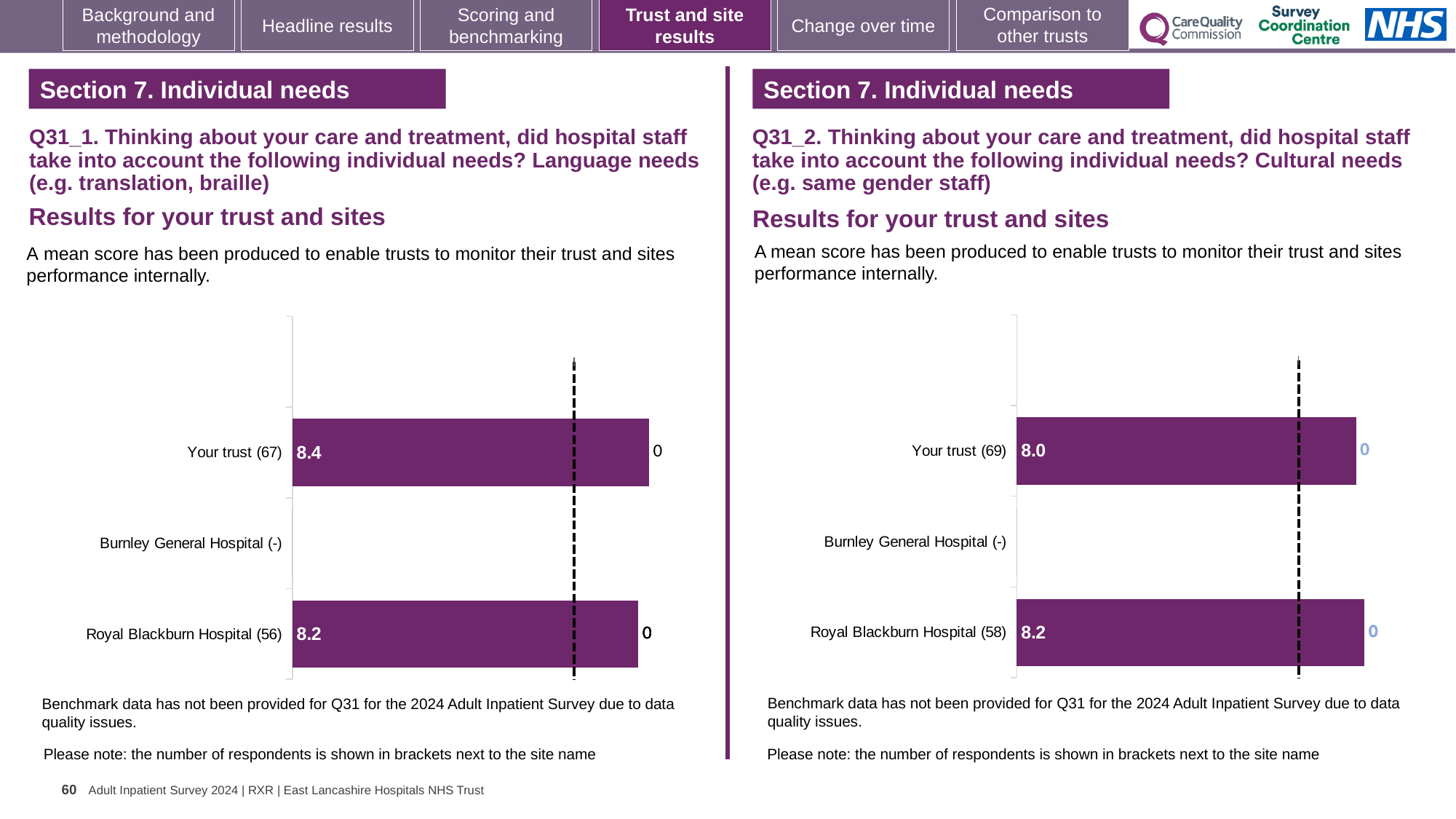
What kind of chart is used in the Q31_2 Cultural needs chart on the right? Bar chart In the Q31_2 Cultural needs chart on the right, what is the difference between the scores for Royal Blackburn Hospital and Your trust? 0.2 In the Q31_1 Language needs chart on the left, what is the mean score for Royal Blackburn Hospital (56)? 8.2 In the Q31_1 Language needs chart on the left, which category has no bar plotted? Burnley General Hospital (-) In the Q31_2 Cultural needs chart on the right, what is the mean score for Your trust (69)? 8.0 How many categories are listed on the y axis of the Q31_1 Language needs chart on the left? 3 In the Q31_1 Language needs chart on the left, what is the difference between the scores for Your trust and Royal Blackburn Hospital? 0.2 In the Q31_1 Language needs chart on the left, which has the higher score: Your trust or Royal Blackburn Hospital? Your trust In the Q31_2 Cultural needs chart on the right, what is the mean score for Royal Blackburn Hospital (58)? 8.2 In the Q31_1 Language needs chart on the left, what is the mean score for Your trust (67)? 8.4 In the Q31_2 Cultural needs chart on the right, which category with a plotted bar has the lowest score? Your trust (69) In the Q31_2 Cultural needs chart on the right, which has the higher score: Your trust or Royal Blackburn Hospital? Royal Blackburn Hospital